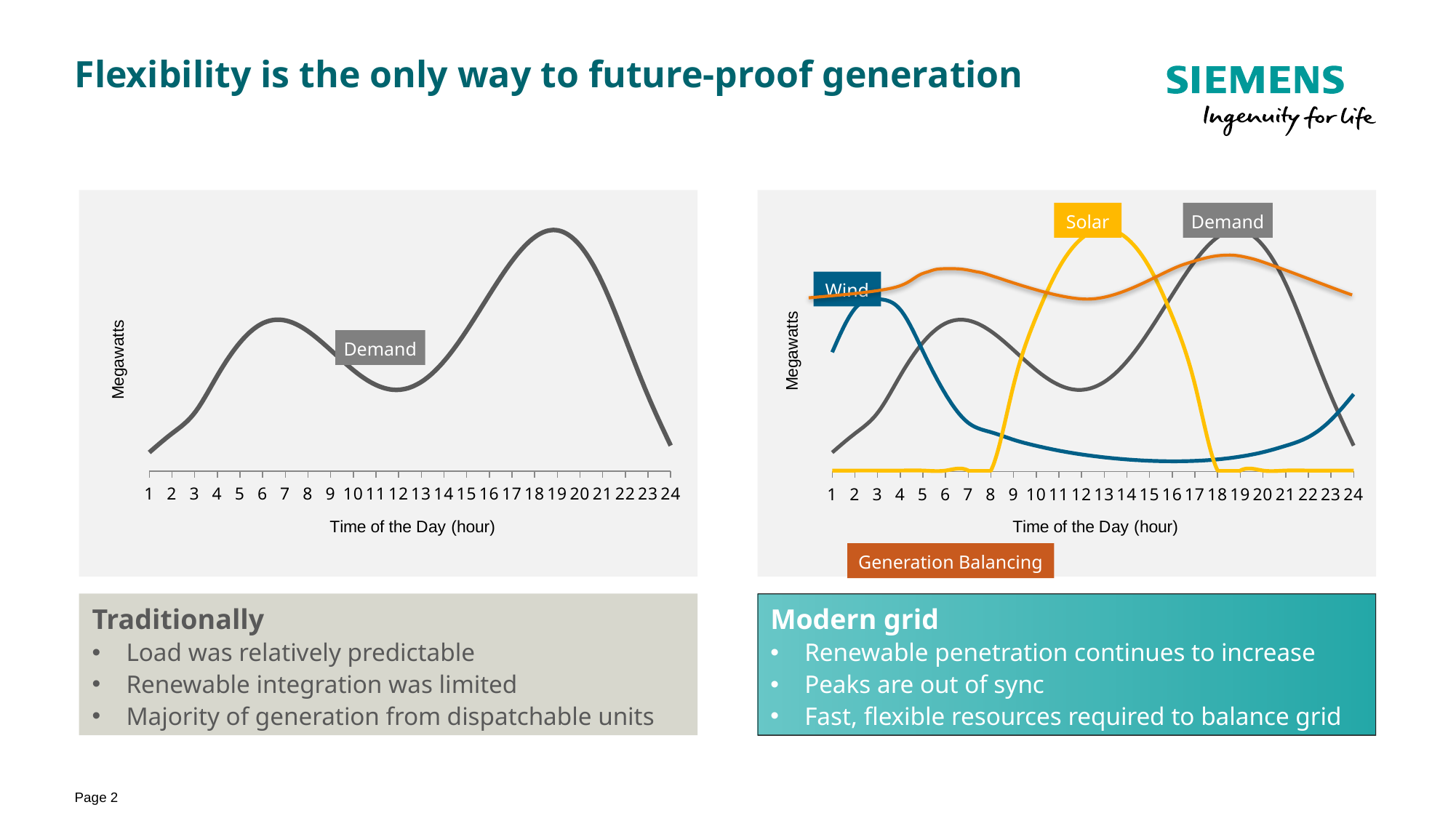
On the right chart, which series is highest at hour 12? Solar What is the y-axis label on the left chart? Megawatts On the right chart, does Demand rise or fall between hour 13 and hour 19? rise How many hours are marked on the x axis of the left chart? 24 On the right chart, at hour 24, which is higher: Wind or Demand? Wind On the left chart, does Demand rise or fall between hour 1 and hour 6? rise On the right chart, which series stays at zero during the night hours (before hour 8 and after hour 18)? Solar On the left chart, does Demand rise or fall between hour 19 and hour 24? fall What kind of chart is the right chart (Modern grid)? line chart How many labelled series are shown on the right chart? 4 On the left chart, at which hour of the day does Demand reach its highest point? 19 What kind of chart is the left chart (Traditionally)? line chart